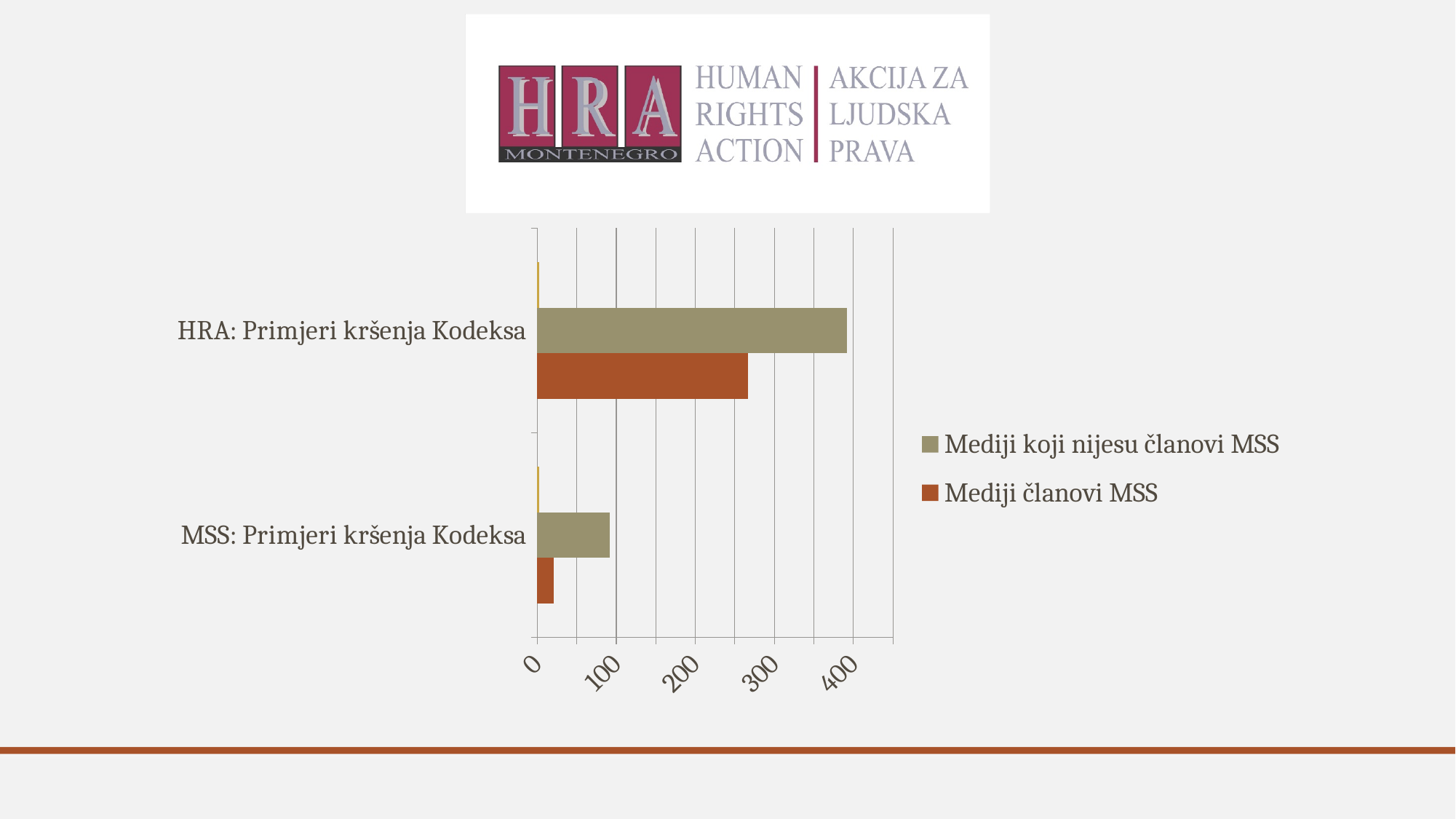
How many categories are shown on the chart? 2 Is the value for "Mediji koji nijesu članovi MSS" in the category "MSS: Primjeri kršenja Kodeksa" greater or less than 100? less How many series does the chart legend list? 2 Is the value for "Mediji članovi MSS" in the category "HRA: Primjeri kršenja Kodeksa" greater or less than 200? greater Is the value for "Mediji članovi MSS" in the category "MSS: Primjeri kršenja Kodeksa" greater or less than 100? less What kind of chart is shown on the slide? bar chart Which legend entry is shown in the orange-brown colour? Mediji članovi MSS Which category has the highest value for the series "Mediji koji nijesu članovi MSS"? HRA: Primjeri kršenja Kodeksa For the series "Mediji članovi MSS", which category has the larger value: "HRA: Primjeri kršenja Kodeksa" or "MSS: Primjeri kršenja Kodeksa"? HRA: Primjeri kršenja Kodeksa In the category "HRA: Primjeri kršenja Kodeksa", which series has the larger value: "Mediji koji nijesu članovi MSS" or "Mediji članovi MSS"? Mediji koji nijesu članovi MSS